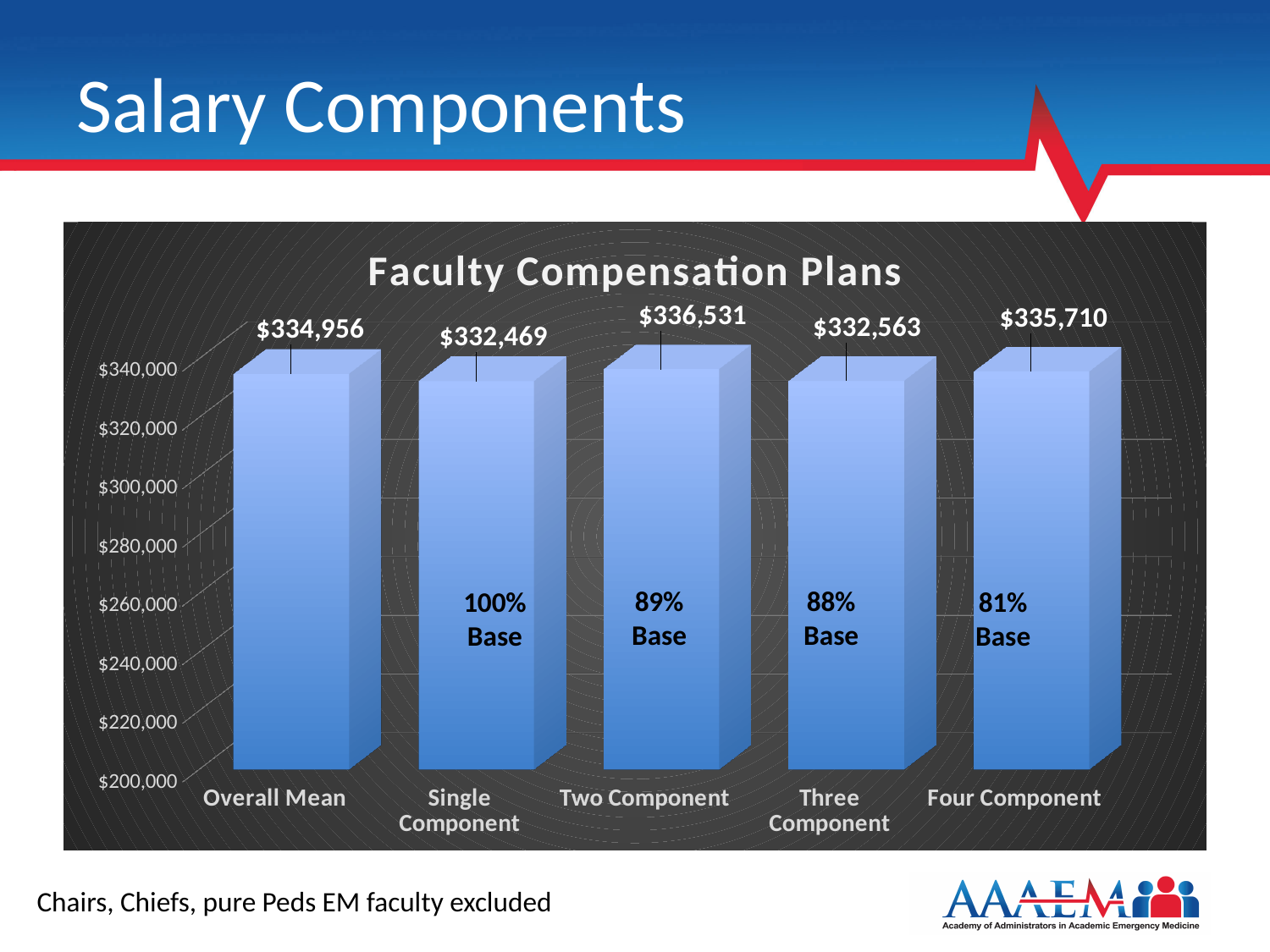
What is the title of the chart? Faculty Compensation Plans Is the value for Three Component greater or less than $320,000? greater How many categories are shown on the x axis? 5 Which is larger, the value for Four Component or the value for Three Component? Four Component Which category has the highest value? Two Component What is the difference between the values for Four Component and Three Component? $3,147 Which category has the lowest value? Single Component What is the value for Four Component? $335,710 What is the value for Single Component? $332,469 What is the value for Two Component? $336,531 What is the difference between the values for Two Component and Single Component? $4,062 What is the value for Overall Mean? $334,956